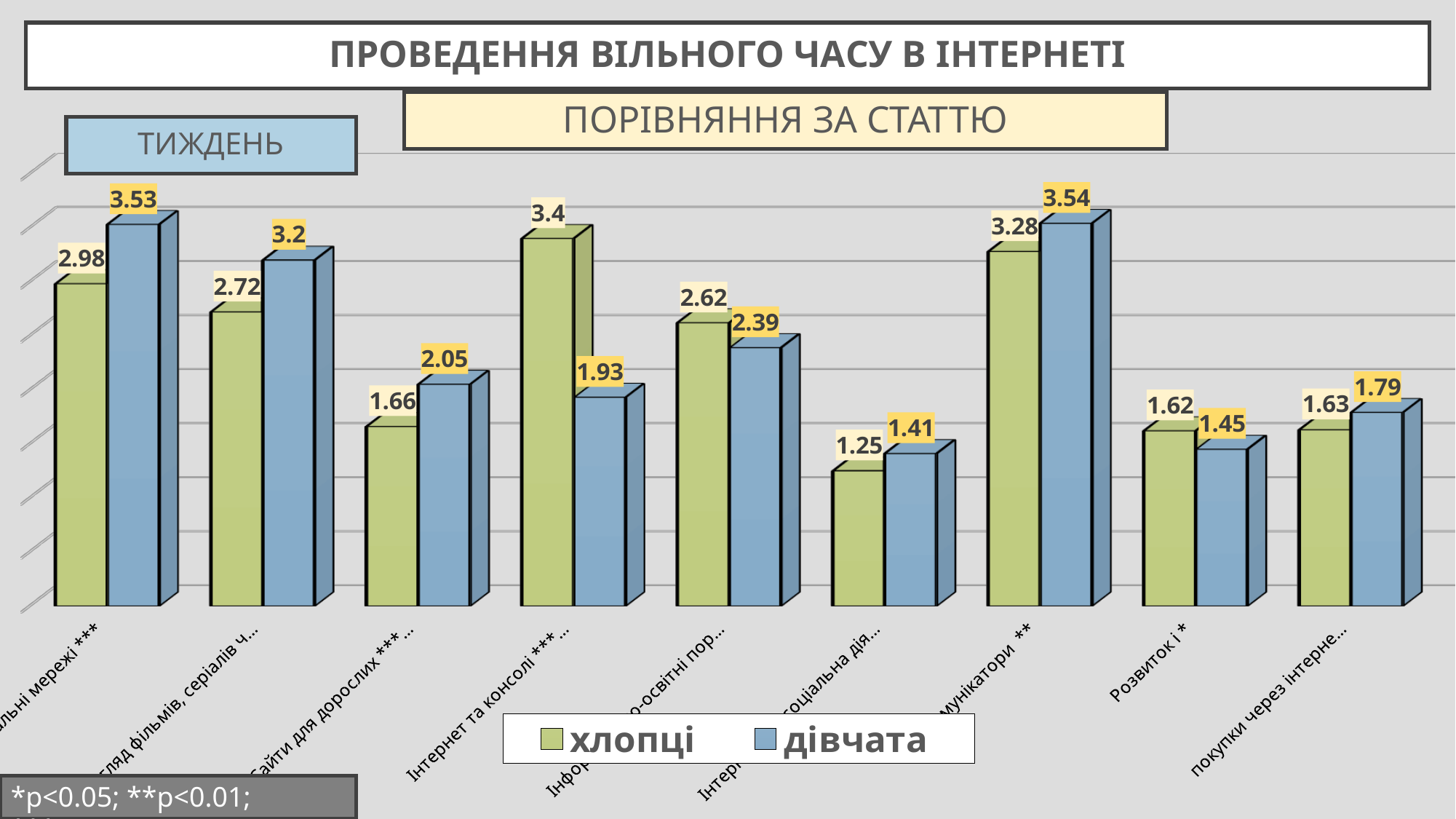
What is the value for хлопці in the last category on the right (покупки через інтерне...)? 1.63 What is the difference between the дівчата and хлопці values in the first category from the left (...льні мережі ***)? 0.55 In the category 'Інтернет та консолі ***', which series has the larger value, хлопці or дівчата? хлопці What is the value for дівчата in the first category from the left (...льні мережі ***)? 3.53 What kind of chart is shown on the slide? bar chart Which two series names appear in the legend? хлопці and дівчата What is the value for дівчата in the category labelled 'Розвиток і *'? 1.45 How many categories are plotted along the x axis? 9 What is the value for хлопці in the category labelled 'Інтернет та консолі ***'? 3.4 In which category is the хлопці value the highest? Інтернет та консолі *** What is the lowest хлопці value shown on the chart? 1.25 How many series does the legend list? 2